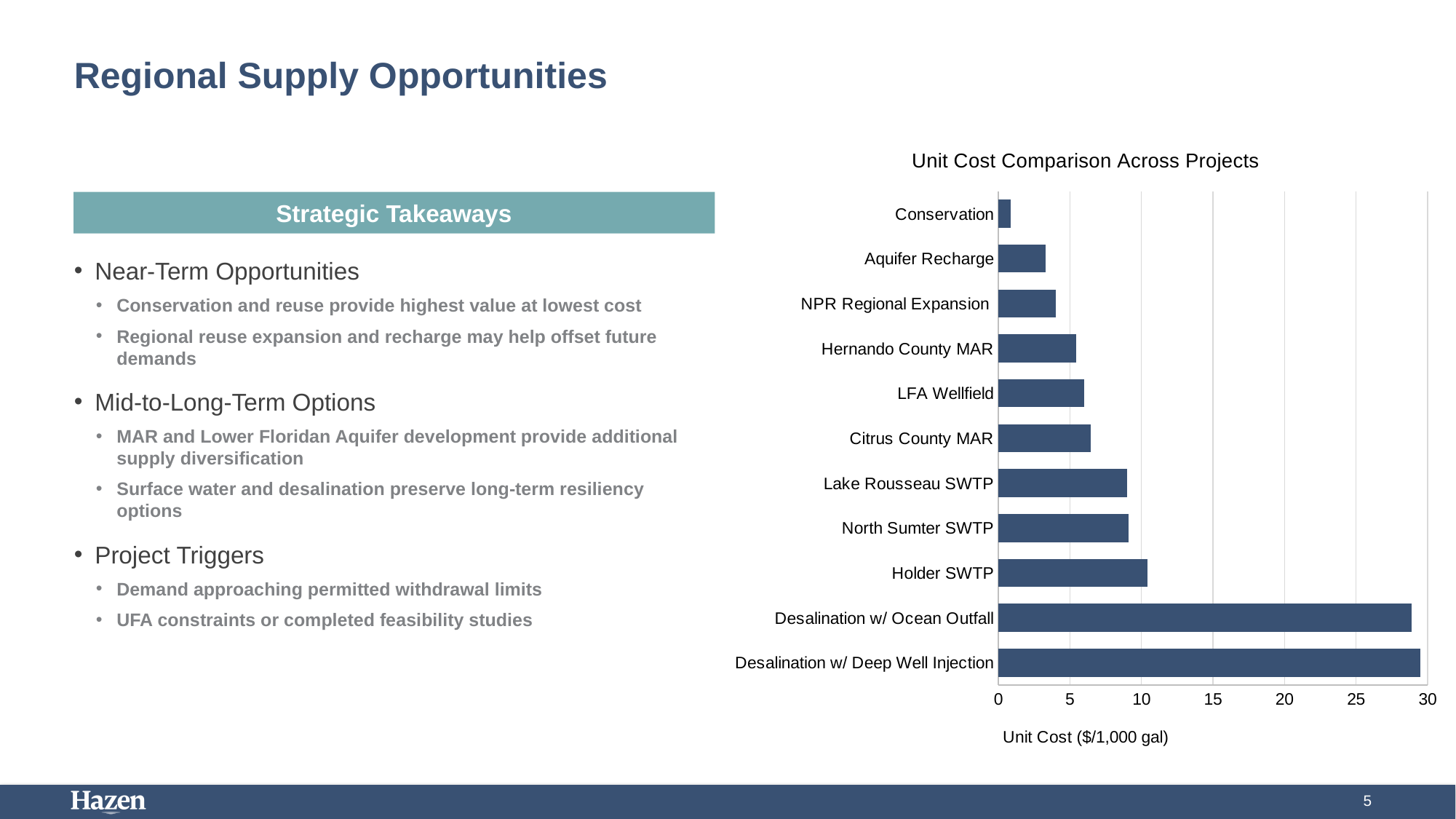
What is the title of the chart on the slide? Unit Cost Comparison Across Projects What is the label of the horizontal axis of the chart? Unit Cost ($/1,000 gal) Is the unit cost for Lake Rousseau SWTP greater or less than 10? less Which has a higher unit cost, Holder SWTP or Citrus County MAR? Holder SWTP Is the unit cost for Citrus County MAR greater or less than 5? greater Is the unit cost for Desalination w/ Ocean Outfall greater or less than 25? greater How many projects are plotted in the chart? 11 Which has a higher unit cost, NPR Regional Expansion or Conservation? NPR Regional Expansion Which project has the lowest unit cost in the chart? Conservation What kind of chart is shown on the slide? Bar chart